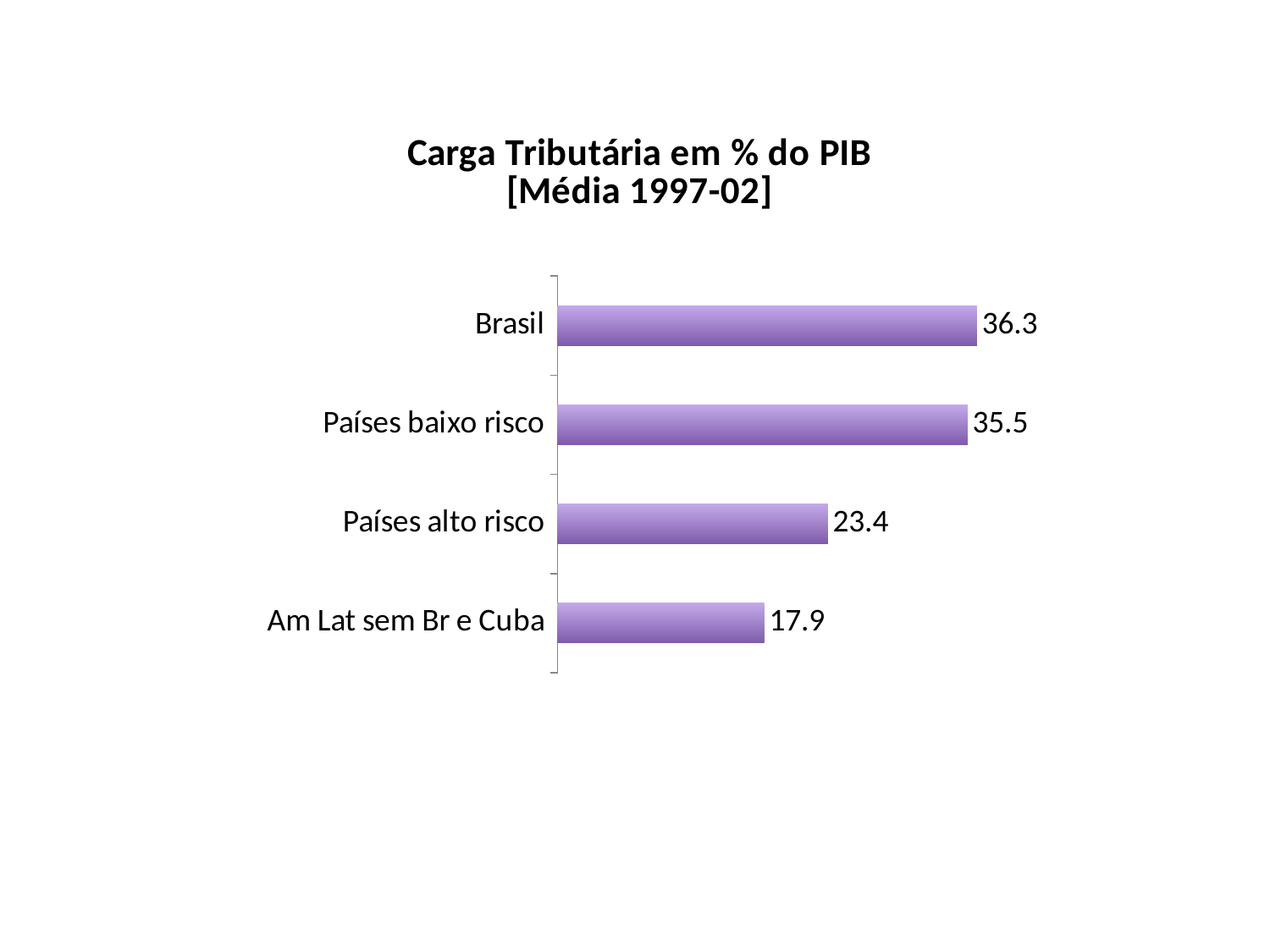
What is the value for Brasil? 36.3 What is the value for Am Lat sem Br e Cuba? 17.9 What is the difference between the values for Brasil and Países baixo risco? 0.8 Which category has the highest value? Brasil What is the value for Países alto risco? 23.4 How many categories are shown in the chart? 4 What is the title of the chart? Carga Tributária em % do PIB [Média 1997-02] What is the value for Países baixo risco? 35.5 Which is larger, the value for Países alto risco or the value for Am Lat sem Br e Cuba? Países alto risco What is the difference between the values for Países alto risco and Am Lat sem Br e Cuba? 5.5 Which category has the lowest value? Am Lat sem Br e Cuba What kind of chart is shown on the slide? Bar chart